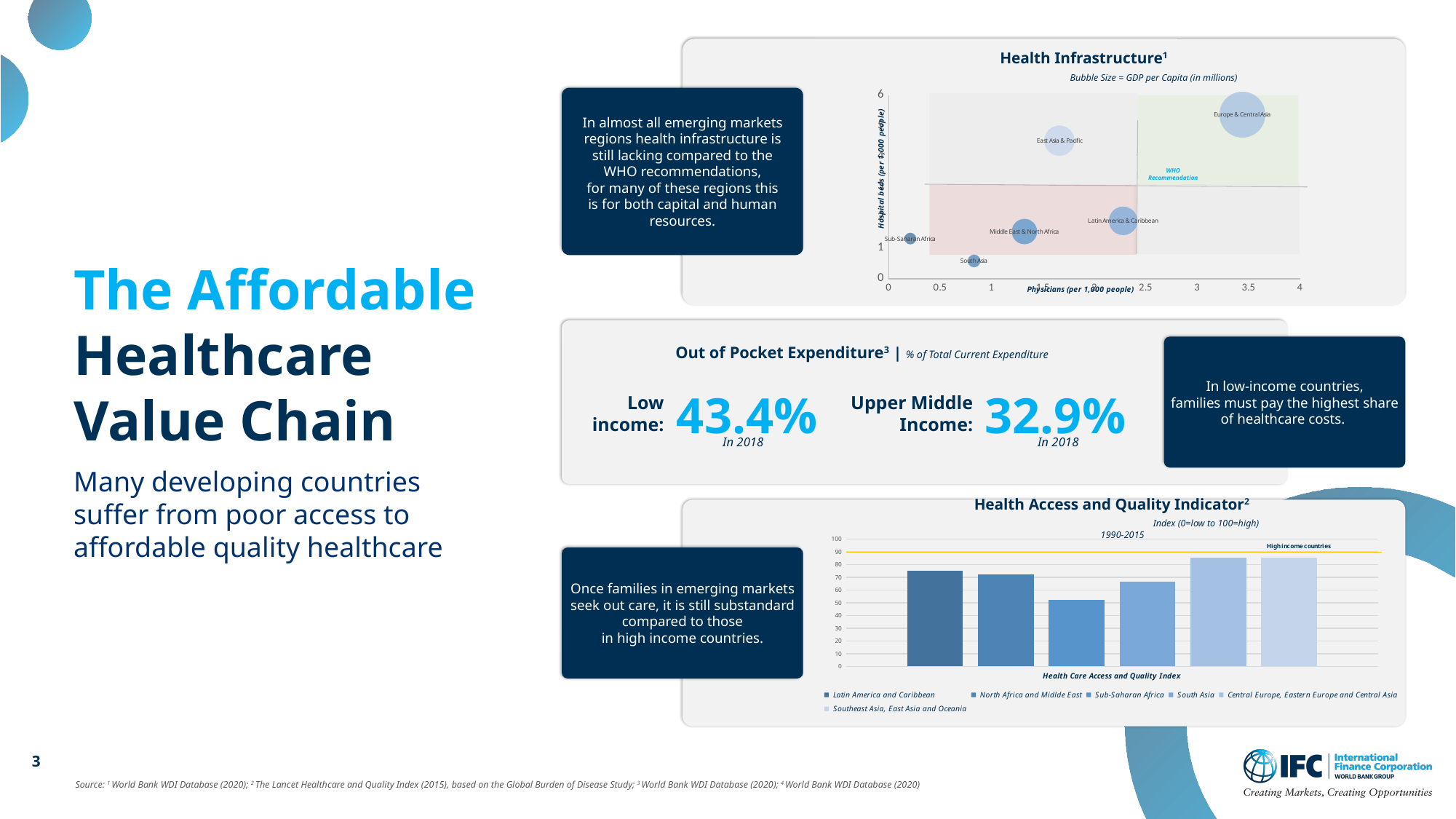
In the Health Access and Quality Indicator chart, is the value for Sub-Saharan Africa greater or less than 60? less What kind of chart is the Health Infrastructure chart? bubble chart In the Health Access and Quality Indicator chart, which region has the lowest index value? Sub-Saharan Africa In the Health Infrastructure chart, which region has the lowest number of hospital beds per 1,000 people? South Asia In the Health Infrastructure chart, is the number of physicians per 1,000 people for Sub-Saharan Africa greater or less than 0.5? less In the Health Infrastructure chart, what does the bubble size represent? GDP per Capita (in millions) In the Health Access and Quality Indicator chart, how many series does the legend list? 6 In the Health Infrastructure chart, how many regions are plotted as bubbles? 6 In the Health Infrastructure chart, which region has the highest number of hospital beds per 1,000 people? Europe & Central Asia In the Health Access and Quality Indicator chart, which is larger, the value for Latin America and Caribbean or the value for Sub-Saharan Africa? Latin America and Caribbean In the Health Infrastructure chart, is the number of physicians per 1,000 people for Europe & Central Asia greater or less than 3? greater What kind of chart is the Health Access and Quality Indicator chart? bar chart